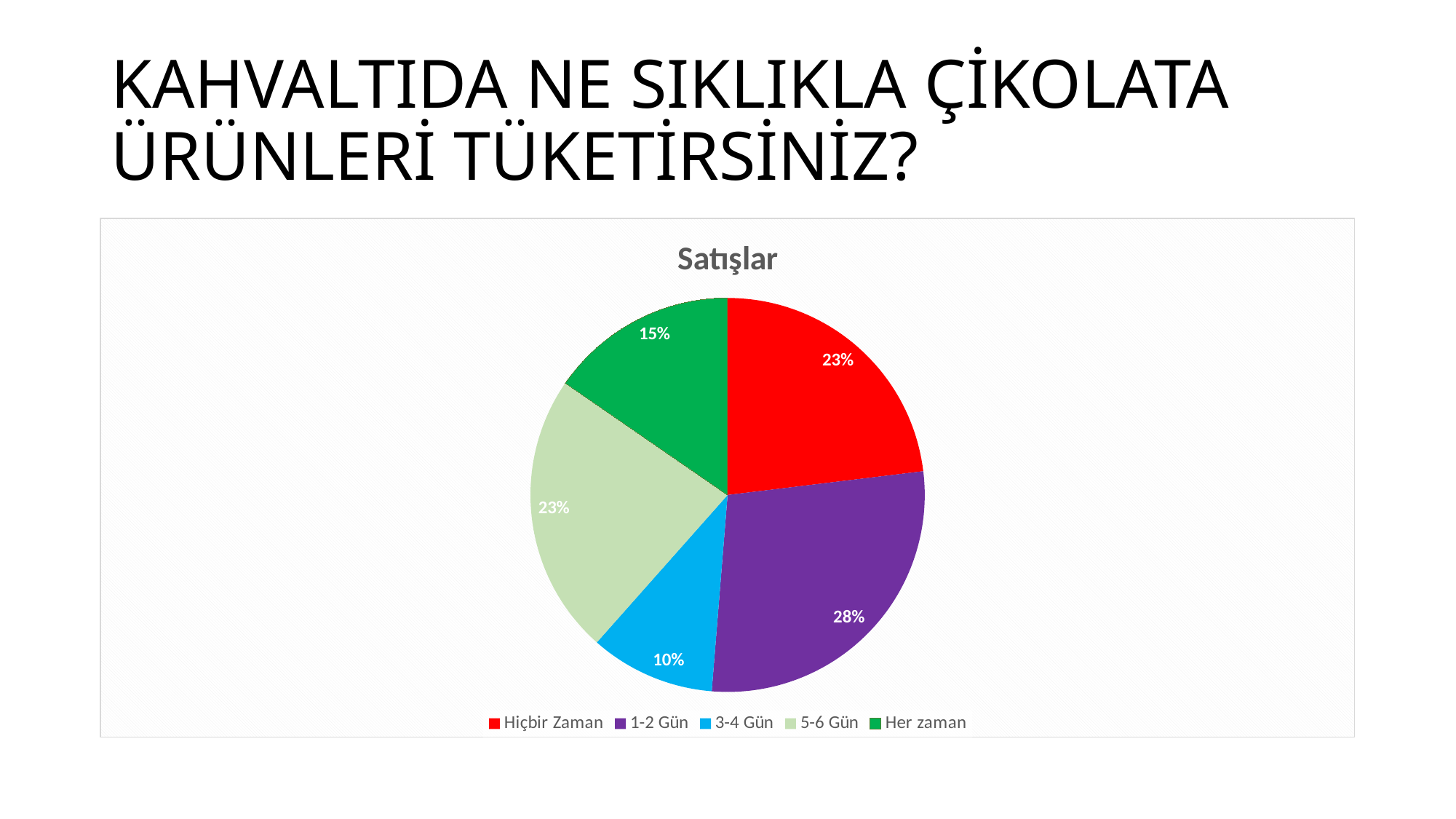
What is the difference in percentage points between the '1-2 Gün' slice and the 'Her zaman' slice? 13 How many categories does the legend list? 5 What percentage share does the '1-2 Gün' slice have? 28% What is the title of the chart? Satışlar Which is larger, the 'Her zaman' slice or the '3-4 Gün' slice? Her zaman What percentage share does the 'Hiçbir Zaman' slice have? 23% What percentage share does the 'Her zaman' slice have? 15% Which category has the largest slice of the pie? 1-2 Gün What type of chart is shown on the slide? Pie chart Which category has the smallest slice of the pie? 3-4 Gün What percentage share does the '5-6 Gün' slice have? 23% What percentage share does the '3-4 Gün' slice have? 10%